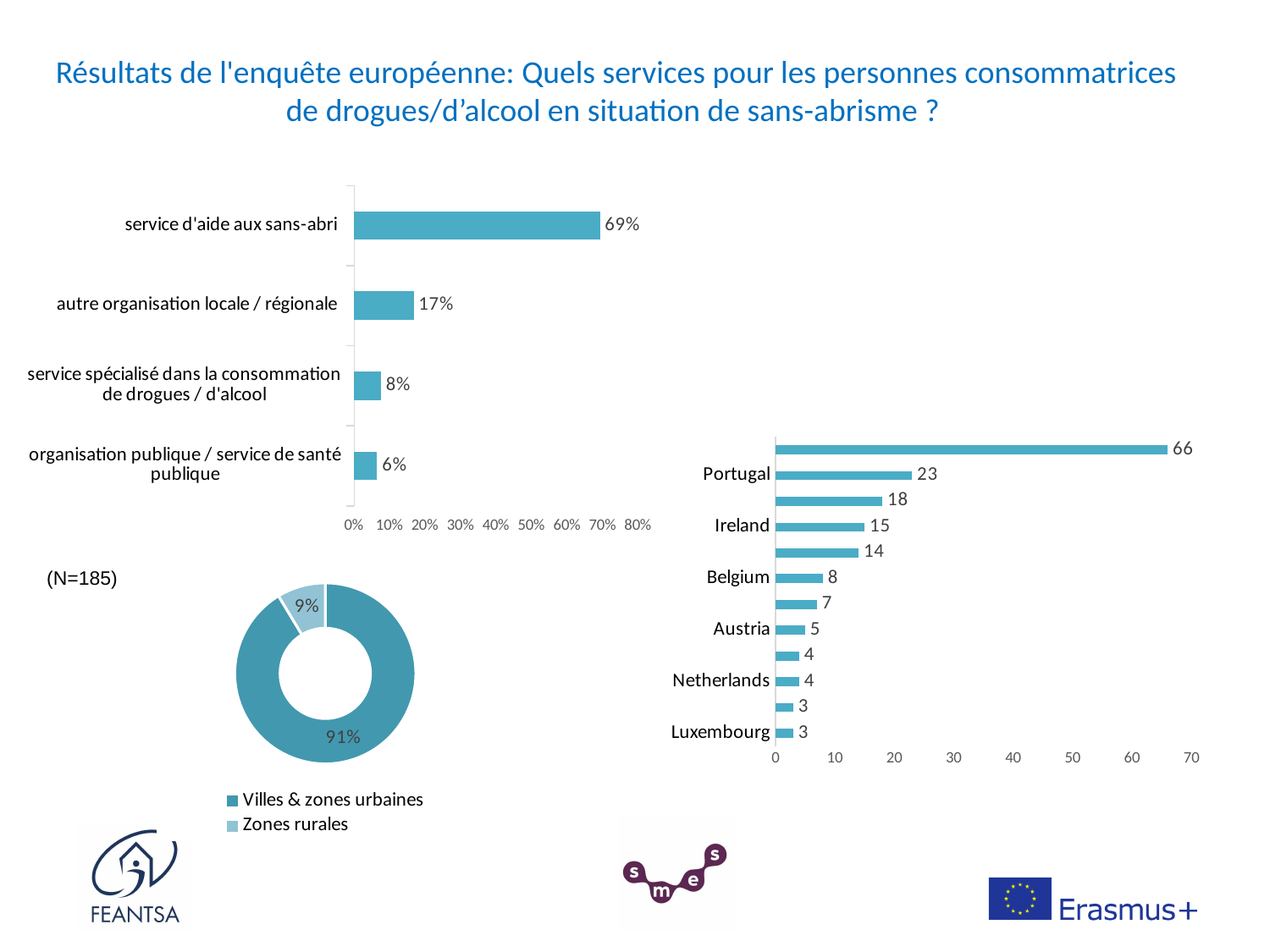
In the top-left bar chart, which category has the lowest value? organisation publique / service de santé publique What type of chart is the top-left chart? Bar chart In the right-hand bar chart, which is larger, the value for Ireland or the value for Austria? Ireland How many categories are shown in the top-left bar chart? 4 In the donut chart, what share is 'Zones rurales'? 9% In the right-hand bar chart, what is the value for Belgium? 8 In the top-left bar chart, what is the difference between 'service d'aide aux sans-abri' and 'service spécialisé dans la consommation de drogues / d'alcool'? 61 percentage points In the top-left bar chart, what percentage is shown for 'autre organisation locale / régionale'? 17% In the right-hand bar chart, what is the value for Portugal? 23 In the top-left bar chart, what percentage is shown for 'service d'aide aux sans-abri'? 69% How many bars are shown in the right-hand bar chart? 12 How many series does the legend of the donut chart list? 2